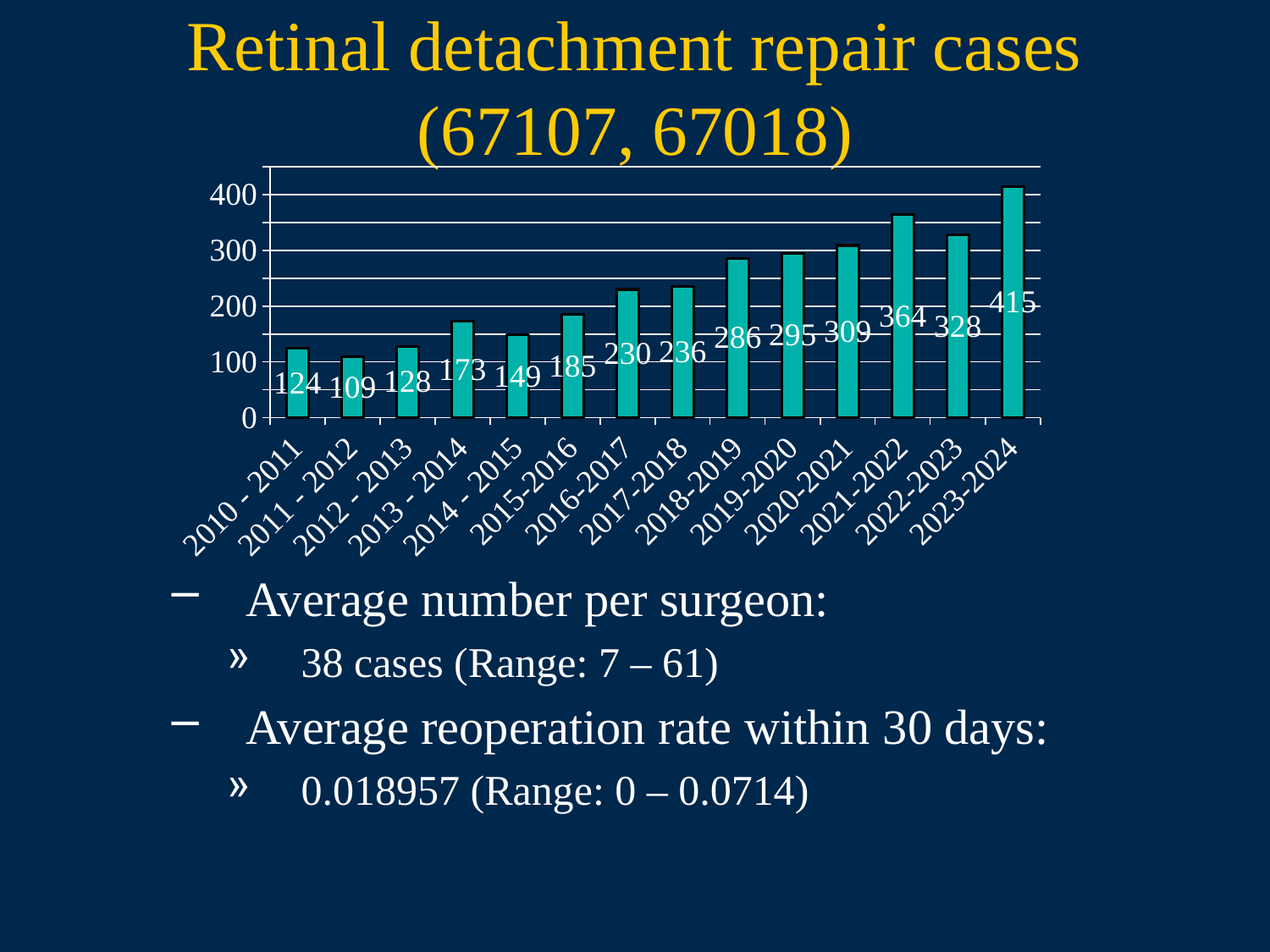
Which year has the highest number of retinal detachment repair cases? 2023-2024 How many categories (academic years) are plotted in the chart? 14 Is the value for 2020-2021 greater or less than 300? greater Overall, do the values rise or fall from 2010 - 2011 to 2023-2024? rise Which year has the lowest number of retinal detachment repair cases? 2011 - 2012 What is the value for 2016-2017? 230 What is the difference between the values for 2023-2024 and 2010 - 2011? 291 What is the value for 2022-2023? 328 Which is larger, the value for 2013 - 2014 or the value for 2014 - 2015? 2013 - 2014 What type of chart is shown on the slide? bar chart What is the value for 2010 - 2011? 124 What is the difference between the values for 2021-2022 and 2022-2023? 36